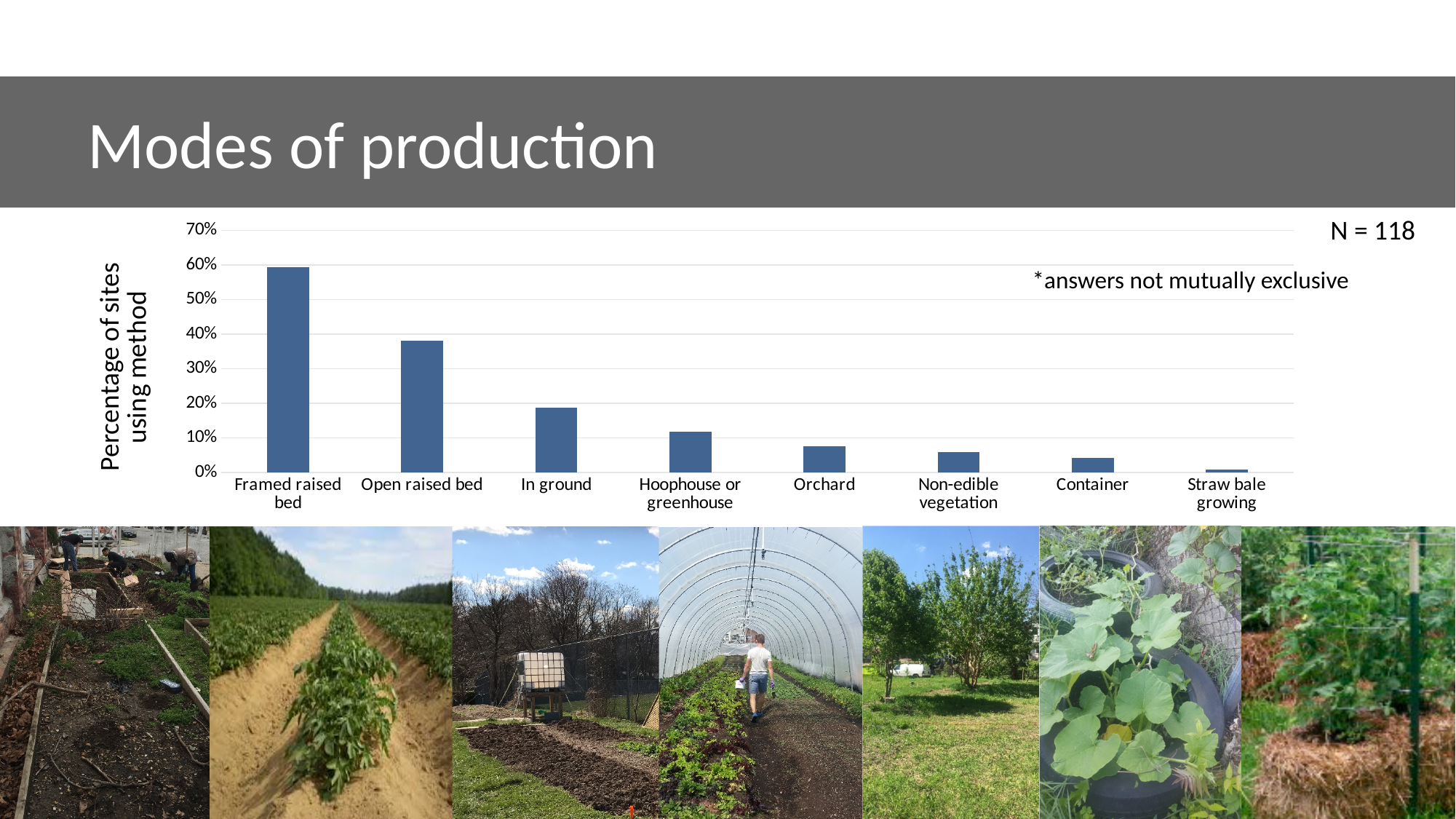
Which mode of production has the lowest percentage of sites using it? Straw bale growing Which mode of production has the highest percentage of sites using it? Framed raised bed Do the bar values rise or fall from left to right along the x axis? fall Which has a higher percentage of sites: Hoophouse or greenhouse, or Container? Hoophouse or greenhouse Which has a higher percentage of sites: Open raised bed or In ground? Open raised bed What kind of chart is shown on the slide? bar chart Is the value for Open raised bed greater or less than 40%? less Is the value for Orchard greater or less than 10%? less Is the value for In ground greater or less than 10%? greater How many categories (modes of production) are shown on the x axis? 8 What is the label on the vertical axis of the chart? Percentage of sites using method